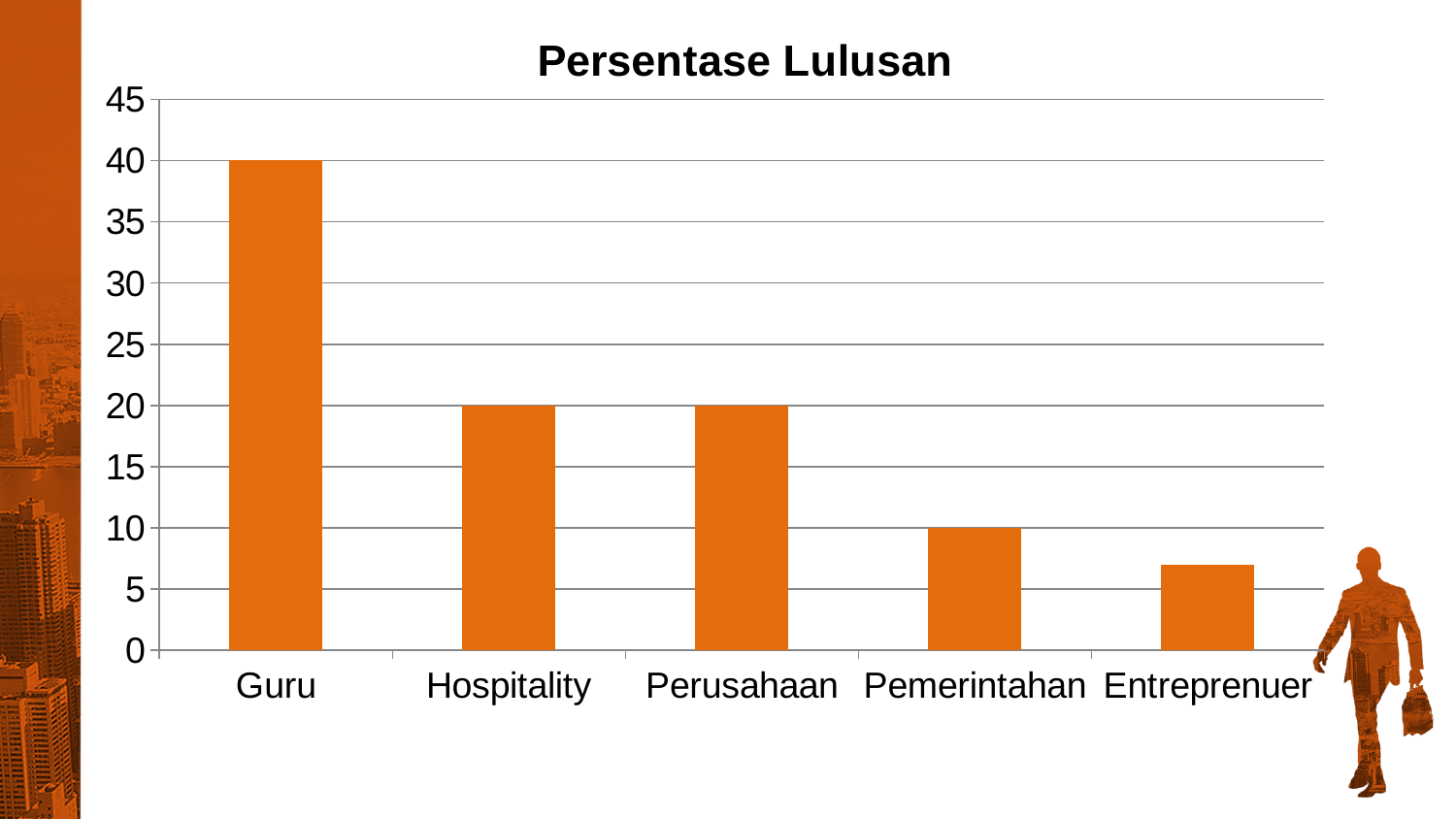
Which category has the highest value? Guru What type of chart is shown on the slide? bar chart Do the values generally rise or fall from left to right along the x axis? fall How many categories are shown on the x axis of the chart? 5 Which category has the lowest value? Entreprenuer What is the value for Hospitality? 20 Which is larger, the value for Guru or the value for Perusahaan? Guru What is the value for Pemerintahan? 10 Is the value for Entreprenuer greater or less than 10? less What is the title of the chart? Persentase Lulusan What is the difference between the values for Guru and Pemerintahan? 30 What is the value for Guru? 40